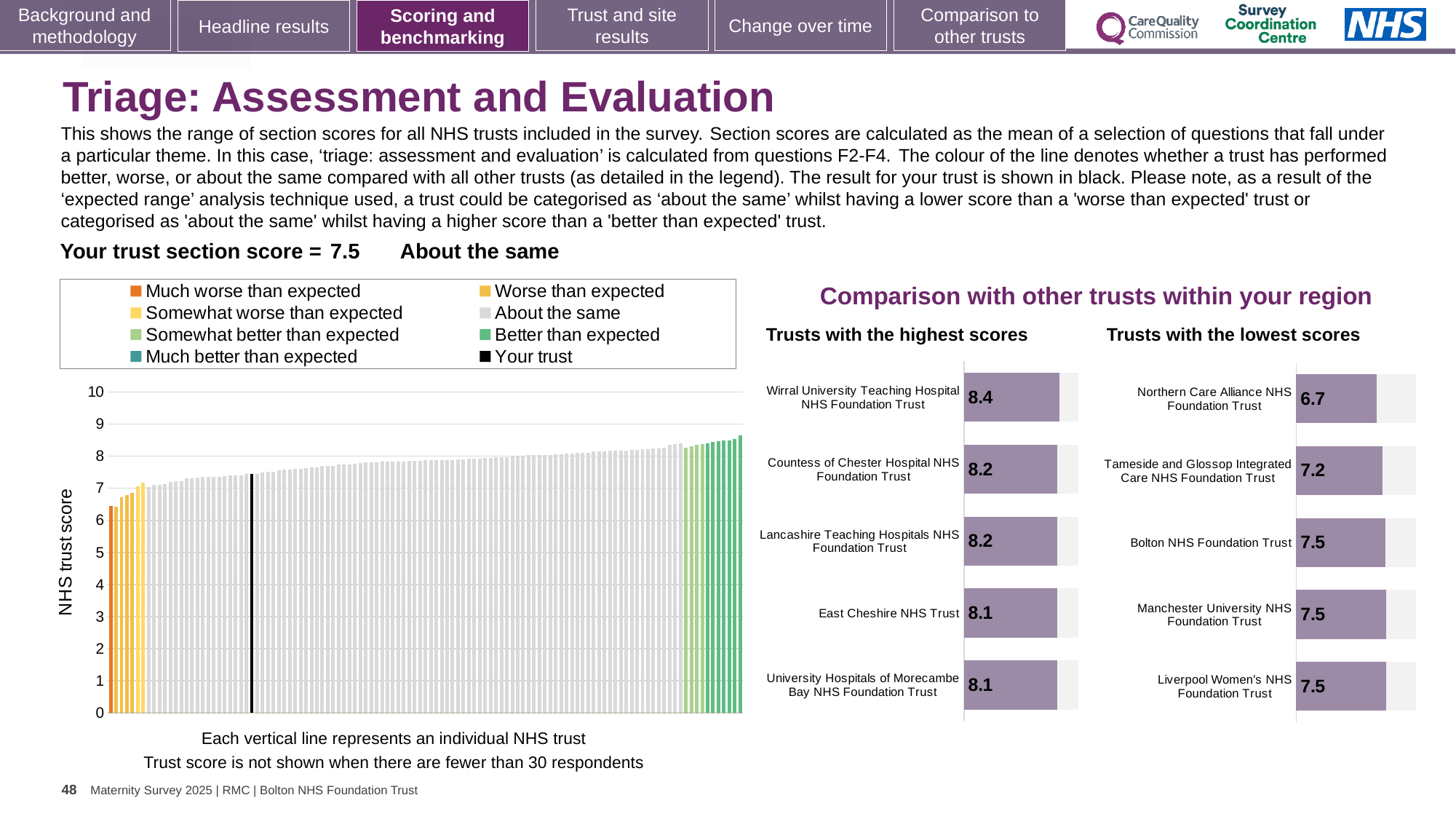
How many entries does the legend of the NHS trust score chart on the left list? 8 What kind of chart is the NHS trust score chart on the left of the slide? Bar chart In the 'Trusts with the lowest scores' chart, what is the difference between the scores of Bolton NHS Foundation Trust and Northern Care Alliance NHS Foundation Trust? 0.8 In the 'Trusts with the lowest scores' chart, what is the score for Tameside and Glossop Integrated Care NHS Foundation Trust? 7.2 In the 'Trusts with the highest scores' chart, which trust has the highest score? Wirral University Teaching Hospital NHS Foundation Trust How many trusts are shown in the 'Trusts with the highest scores' chart? 5 In the 'Trusts with the lowest scores' chart, which trust has the lowest score? Northern Care Alliance NHS Foundation Trust In the 'Trusts with the highest scores' chart, what is the difference between the scores of Wirral University Teaching Hospital NHS Foundation Trust and East Cheshire NHS Trust? 0.3 In the 'Trusts with the highest scores' chart, which has the larger score: Countess of Chester Hospital NHS Foundation Trust or East Cheshire NHS Trust? Countess of Chester Hospital NHS Foundation Trust In the 'Trusts with the highest scores' chart, what is the score for Wirral University Teaching Hospital NHS Foundation Trust? 8.4 In the NHS trust score chart on the left, do the values rise or fall from left to right? Rise In the NHS trust score chart on the left, is the value for the black 'Your trust' bar greater or less than 5? greater